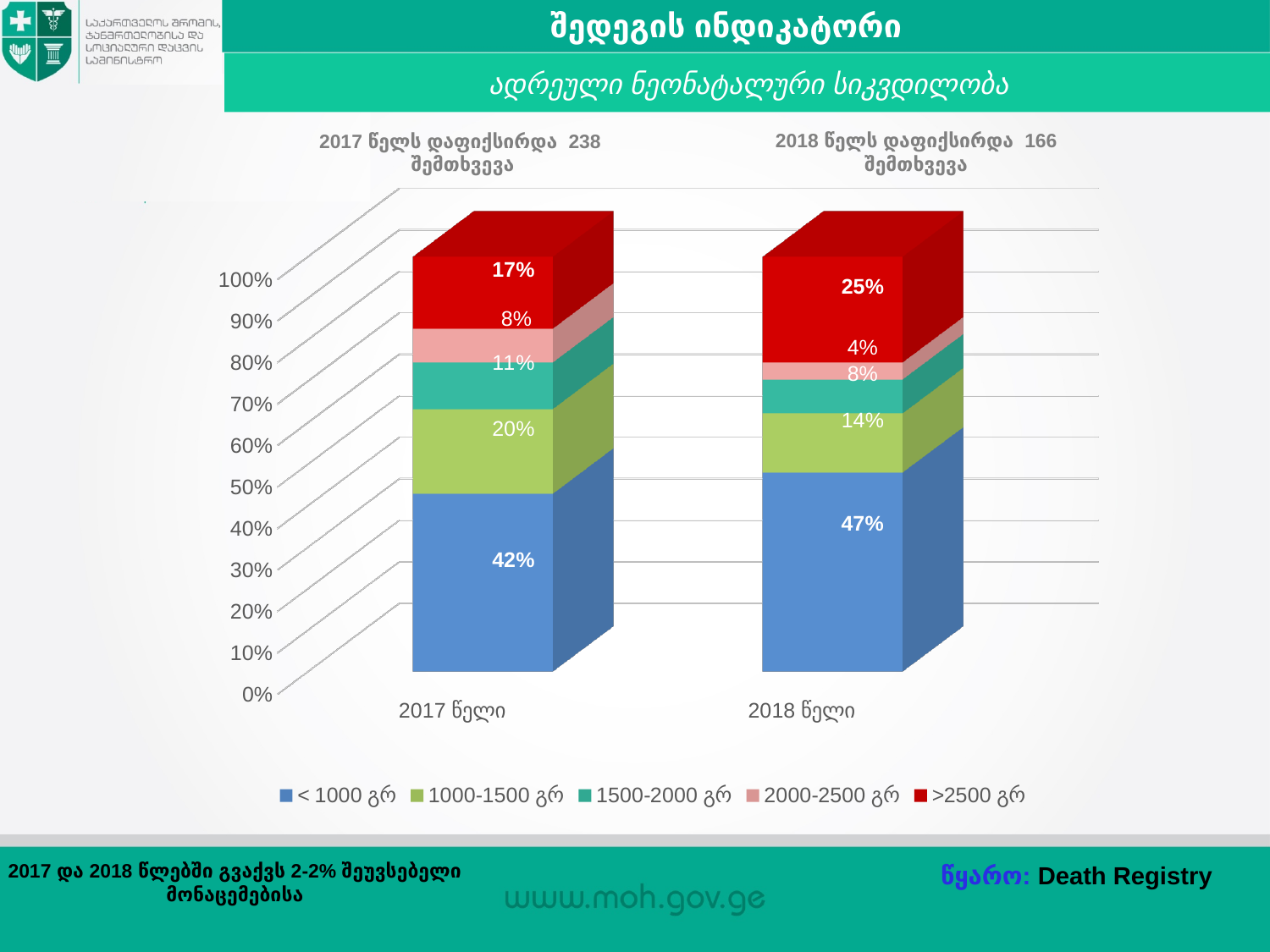
According to the text above the chart, how many cases were recorded in 2017? 238 What type of chart is shown on the slide? stacked bar chart What is the value of the >2500 გრ segment for 2018 წელი? 25% What is the difference between the >2500 გრ values for 2018 წელი and 2017 წელი? 8% Which segment is the largest in the 2018 წელი bar? < 1000 გრ What is the value of the 1000-1500 გრ segment for 2018 წელი? 14% Which segment is the smallest in the 2018 წელი bar? 2000-2500 გრ How many series does the legend list? 5 How many bars (categories) are plotted on the x axis? 2 What is the value of the < 1000 გრ segment for 2017 წელი? 42% Which year has the larger 1500-2000 გრ share, 2017 წელი or 2018 წელი? 2017 წელი What is the value of the 2000-2500 გრ segment for 2017 წელი? 8%